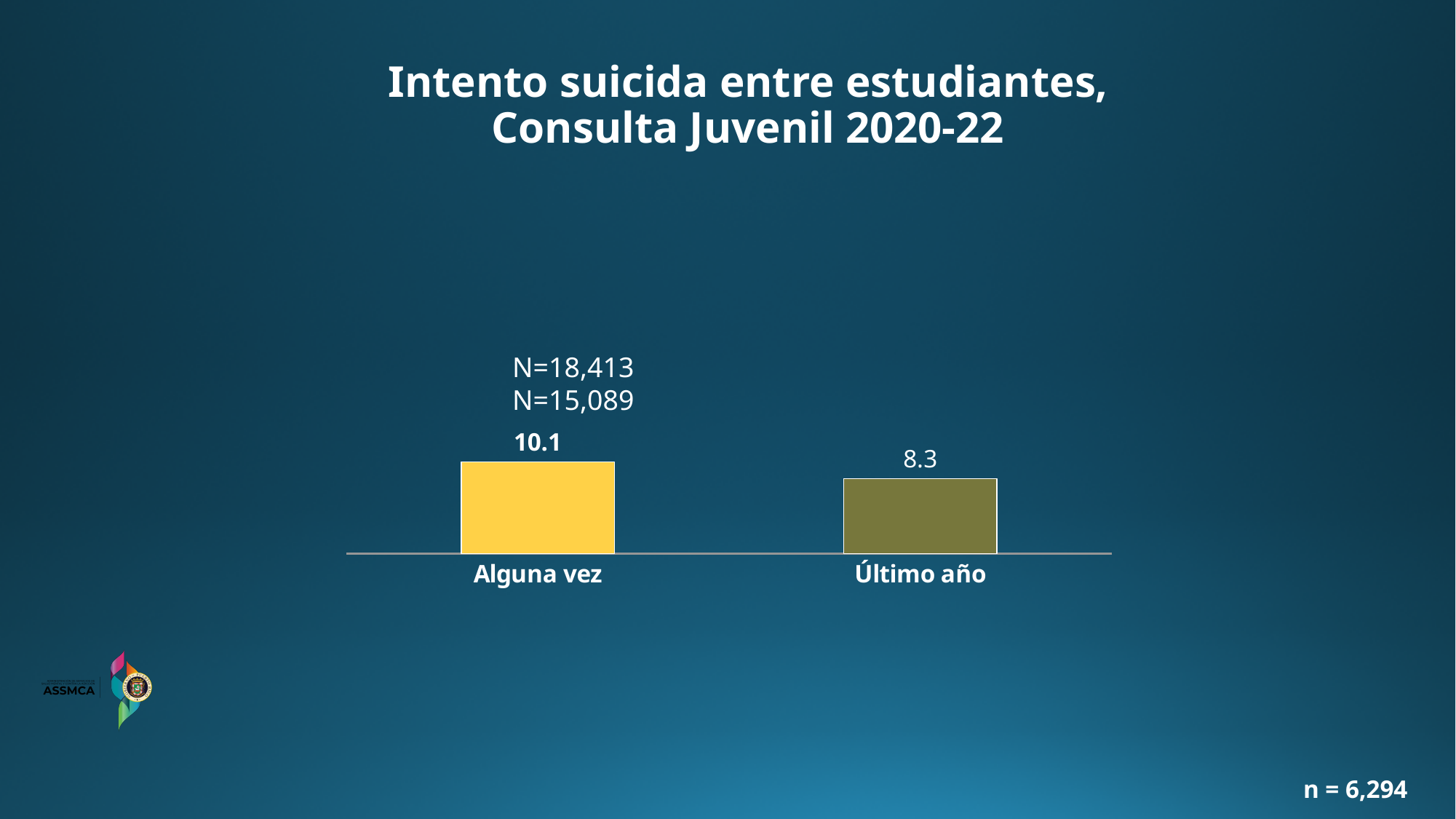
Which category has the lowest value? Último año Which category has the highest value? Alguna vez What is the value for Último año? 8.3 What kind of chart is shown on the slide? Bar chart What is the title of the chart? Intento suicida entre estudiantes, Consulta Juvenil 2020-22 What is the value for Alguna vez? 10.1 Do the values rise or fall from Alguna vez to Último año? Fall How many categories are shown in the chart? 2 What is the difference between the values for Alguna vez and Último año? 1.8 Which is larger, the value for Alguna vez or the value for Último año? Alguna vez What sample size (n) is shown at the bottom right of the slide? n = 6,294